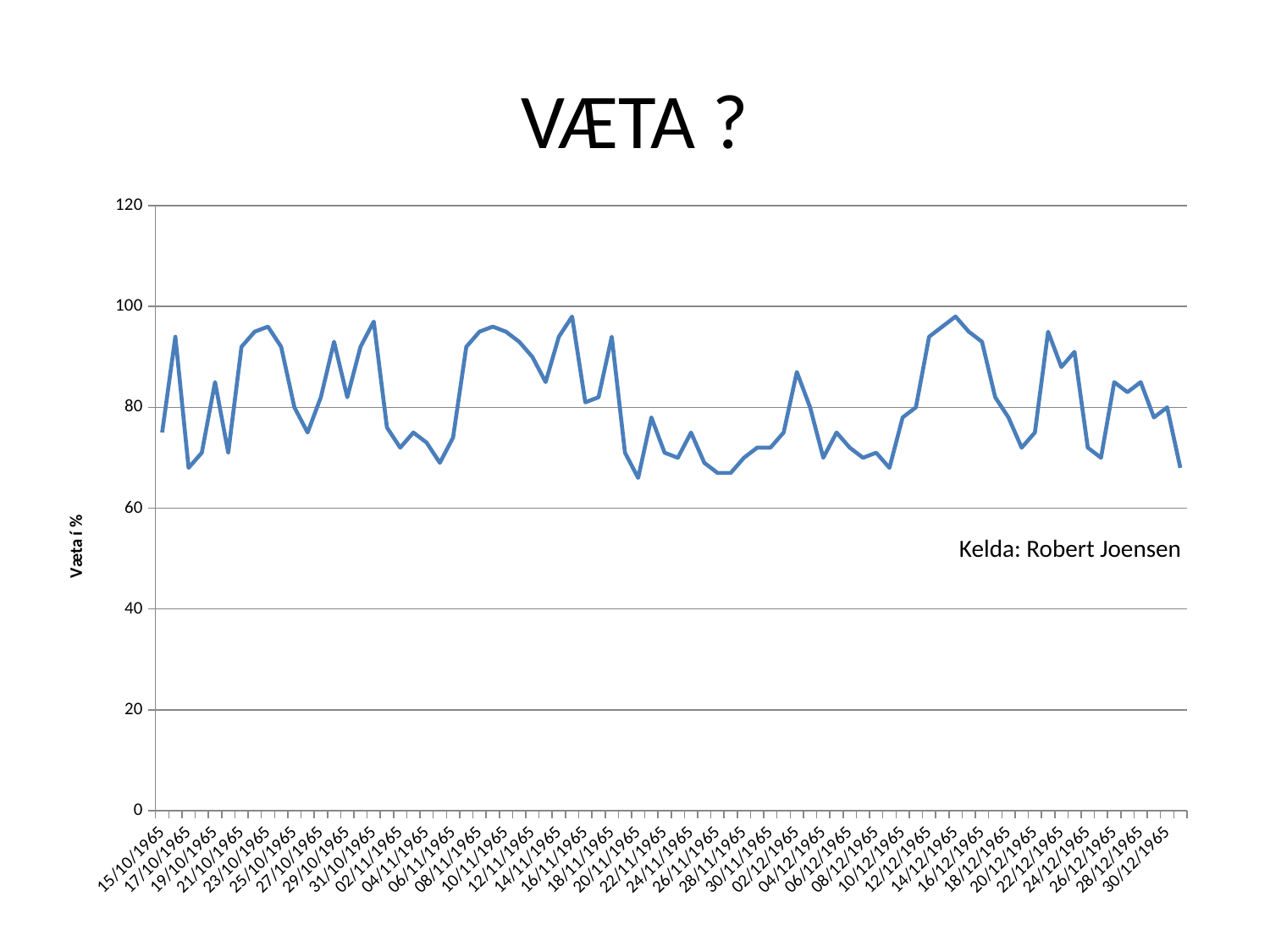
Is the value for 06/12/1965 greater or less than 80? less What is the title of the chart? VÆTA ? Is the value for 15/10/1965 greater or less than 60? greater Is the value for 15/10/1965 greater or less than 80? less What is the label on the vertical axis of the chart? Væta í % What kind of chart is shown on the slide? line chart